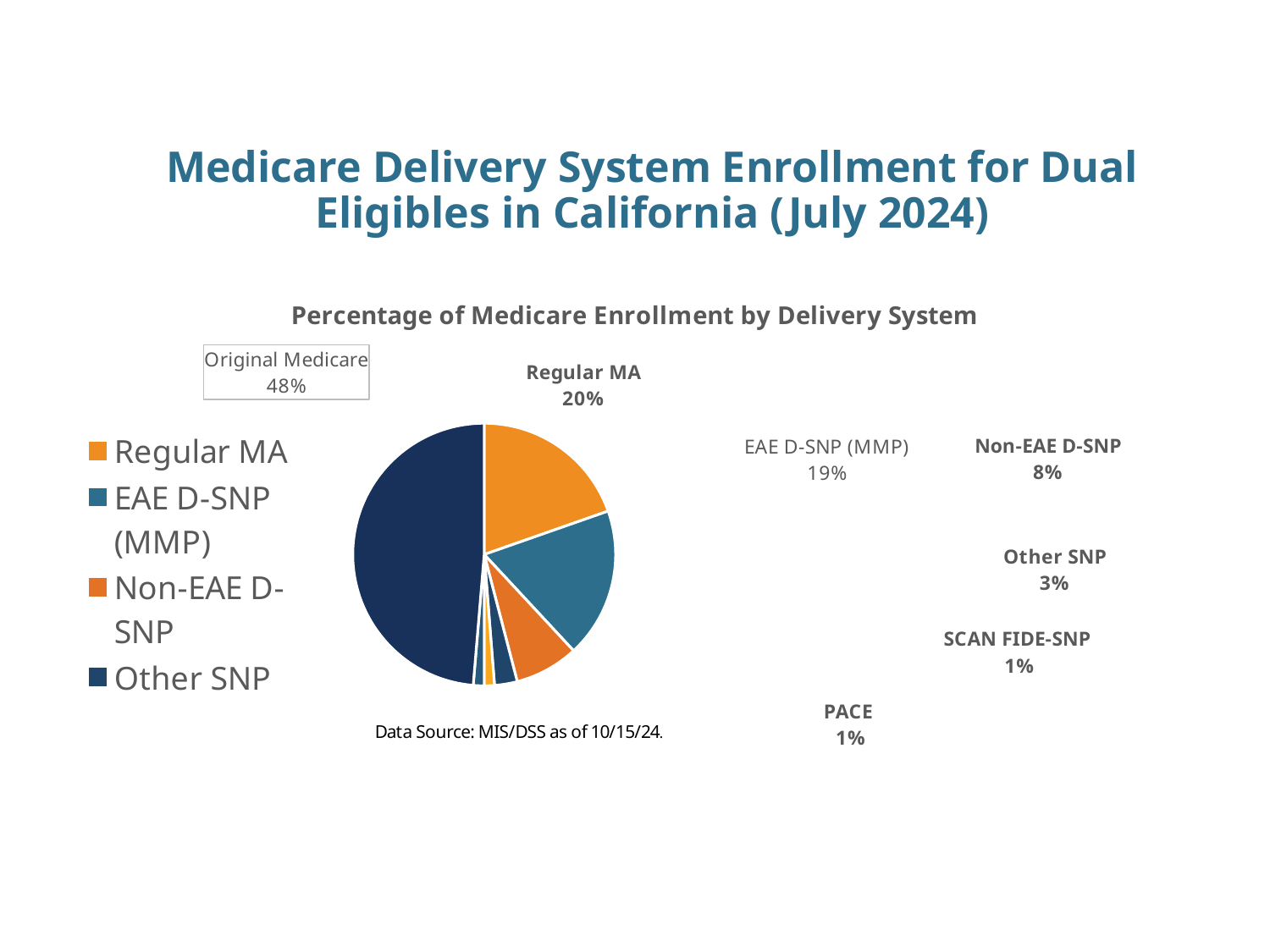
What is the value shown for EAE D-SNP (MMP)? 19% What is the chart's title? Percentage of Medicare Enrollment by Delivery System Which is larger, the share for Regular MA or the share for Non-EAE D-SNP? Regular MA How many slices does the pie chart have? 7 What type of chart is shown on the slide? Pie chart Which delivery system has the largest share of the pie? Original Medicare What is the value shown for Non-EAE D-SNP? 8% What is the difference in percentage points between Original Medicare and Regular MA? 28 What percentage of Medicare enrollment is in Original Medicare? 48% What percentage of Medicare enrollment is in Regular MA? 20% What is the value shown for Other SNP? 3% What is the combined share of SCAN FIDE-SNP and PACE? 2%